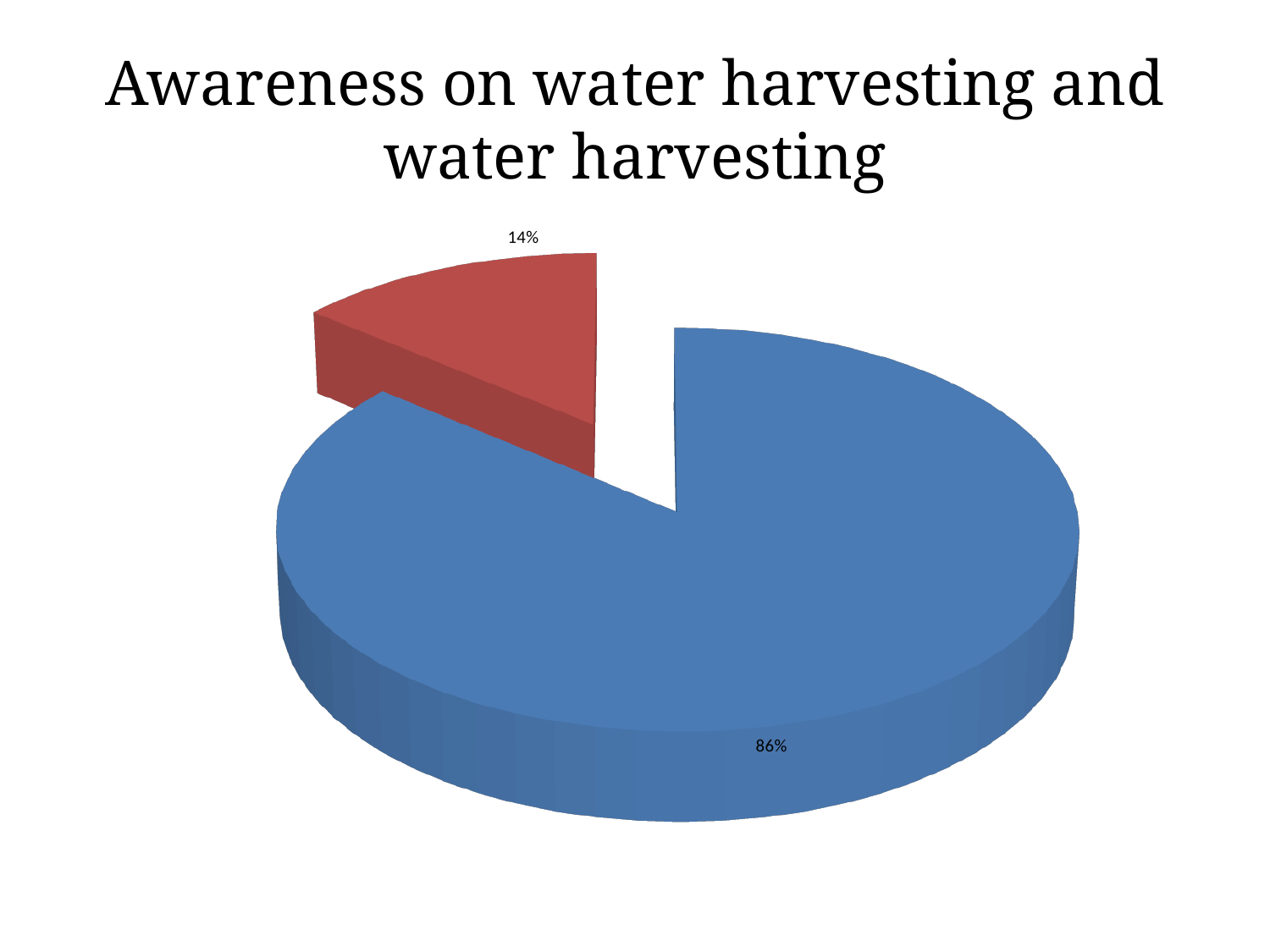
Which slice of the pie is the smallest? the red slice Which is larger, the blue slice or the red slice? the blue slice What share of the pie does the blue slice represent? 86% What is the title of the slide? Awareness on water harvesting and water harvesting What share of the pie does the red slice represent? 14% What kind of chart is shown on the slide? pie chart Which slice of the pie is the largest? the blue slice Which slice is pulled out (exploded) from the pie? the red slice Is the share of the red slice greater or less than 50%? less What is the difference in percentage points between the blue slice and the red slice? 72 How many slices does the pie chart have? 2